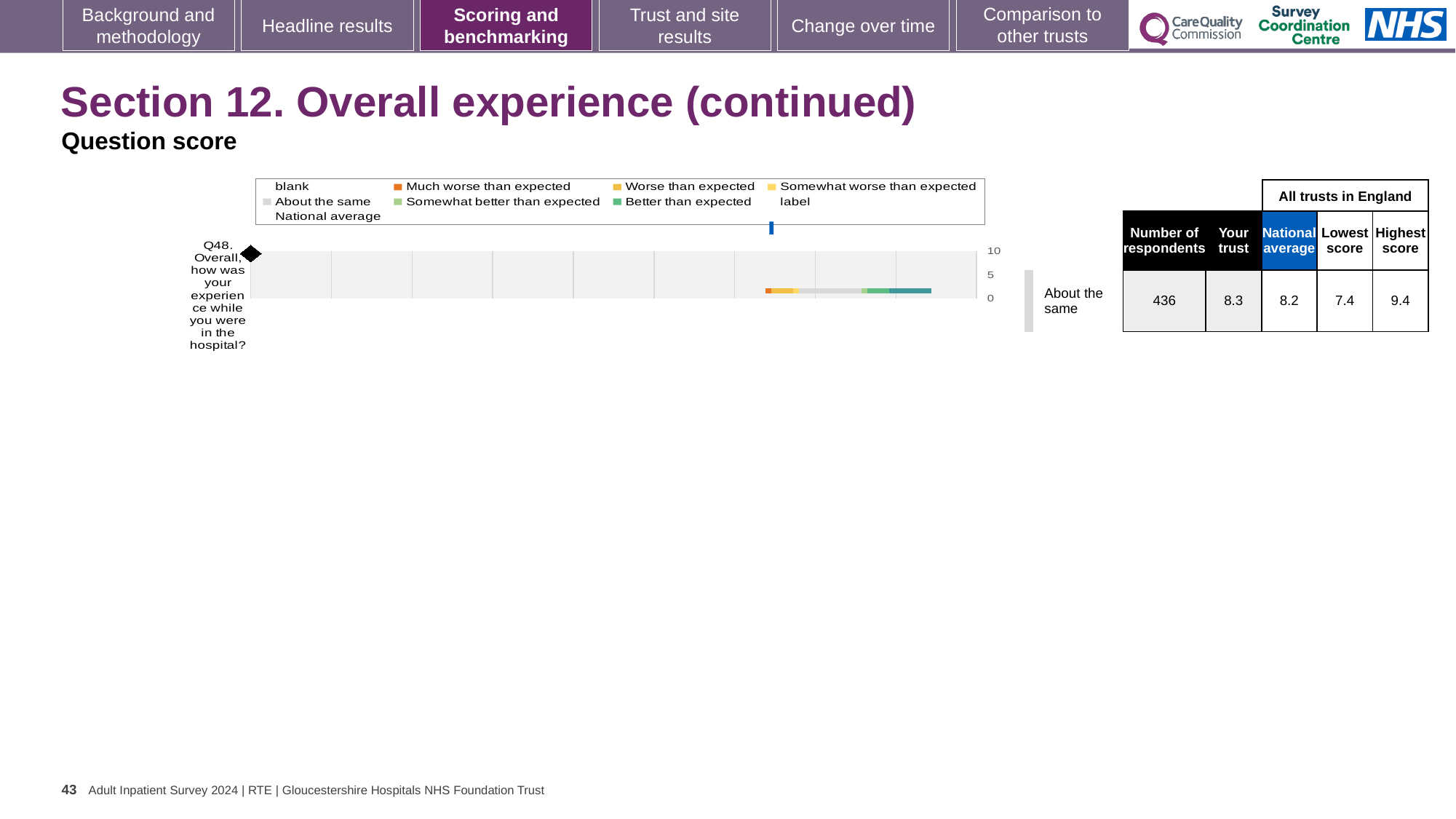
Is the trust's score for Q48 greater or less than 5? greater According to the table beside the chart, what is the highest score among all trusts in England for Q48? 9.4 What benchmark category is the trust's Q48 score placed in? About the same What is the highest value shown on the chart's axis? 10 According to the table beside the chart, what is the national average for Q48? 8.2 What kind of chart is shown on the slide? bar chart How many questions are plotted on the chart? 1 According to the table beside the chart, what is the lowest score among all trusts in England for Q48? 7.4 According to the table beside the chart, how many respondents answered Q48? 436 Which question is plotted on the chart? Q48. Overall, how was your experience while you were in the hospital? According to the table beside the chart, what is the trust's score for Q48? 8.3 Is the trust's Q48 score higher or lower than the national average? higher